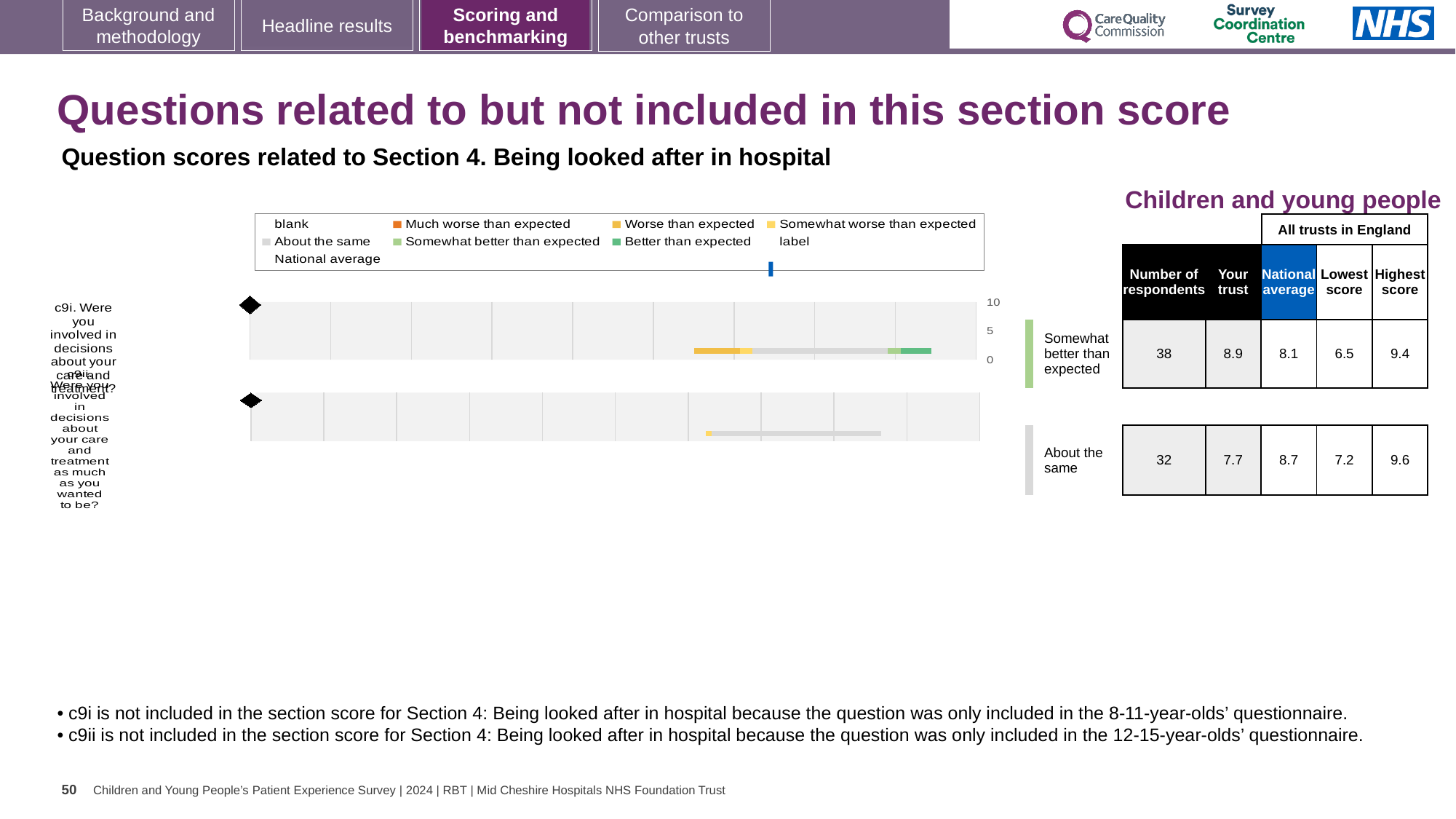
What is the highest score across all trusts in England for question c9ii? 9.6 What is the difference between the 'Your trust' scores for c9i and c9ii? 1.2 What benchmark category is shown for question c9i? Somewhat better than expected How many questions are plotted in the chart? 2 According to the table beside the chart, what is the 'Your trust' score for question c9i? 8.9 Which question has the higher 'Your trust' score, c9i or c9ii? c9i What is the maximum value shown on the chart's score axis? 10 What is the national average score for question c9i? 8.1 According to the table beside the chart, what is the 'Your trust' score for question c9ii? 7.7 How many respondents answered question c9i? 38 What kind of chart is used to show the question scores on this slide? bar chart What is the national average score for question c9ii? 8.7